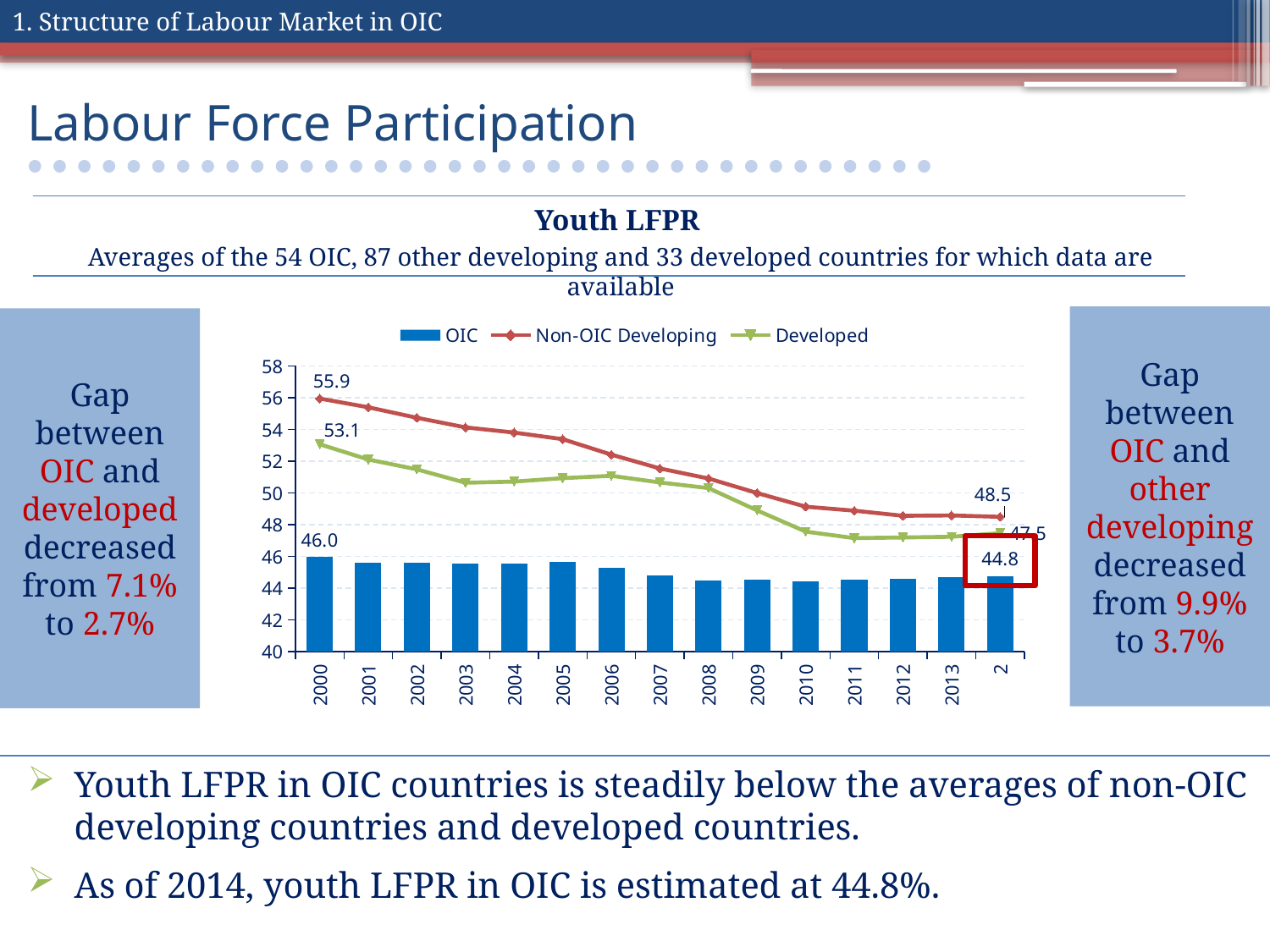
What is the Non-OIC Developing value labelled at the last point on the x axis? 48.5 How many series does the legend list? 3 What is the OIC youth LFPR value shown for 2000? 46.0 What is the Developed value shown for 2000? 53.1 Does the Non-OIC Developing line rise or fall from 2000 to the end of the x axis? Fall Is the OIC value for 2010 greater or less than 46? less What is the Non-OIC Developing value shown for 2000? 55.9 What kind of chart is this? Combined bar and line chart At the last point on the x axis, what is the difference between the Non-OIC Developing value and the OIC value? 3.7 What is the OIC value labelled at the last bar on the x axis? 44.8 In 2000, what is the difference between the Non-OIC Developing value and the OIC value? 9.9 In 2000, what is the difference between the Developed value and the OIC value? 7.1